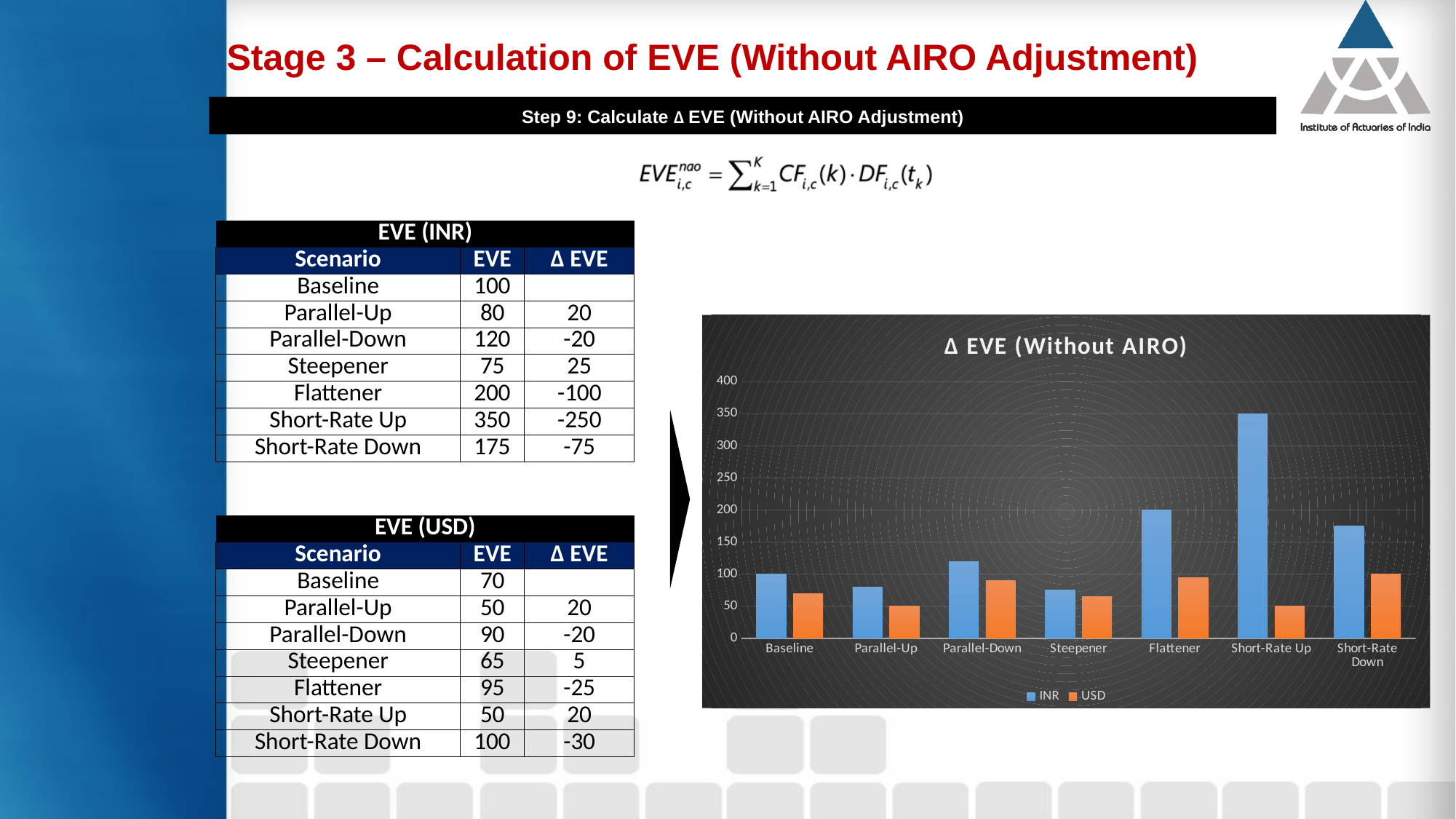
What is the USD value for Short-Rate Down in the chart? 100 Is the INR value for Short-Rate Down greater or less than 150? greater Which is larger for Parallel-Down: the INR bar or the USD bar? INR How many series does the chart legend list? 2 Which scenario has the lowest INR bar in the chart? Steepener What is the INR value for Flattener in the chart? 200 What is the INR value for Short-Rate Up in the chart? 350 What is the title of the chart? Δ EVE (Without AIRO) Which scenario has the highest INR bar in the chart? Short-Rate Up Is the USD value for Flattener greater or less than 100? less How many scenario categories are shown on the x axis of the chart? 7 What kind of chart is shown on the slide? bar chart